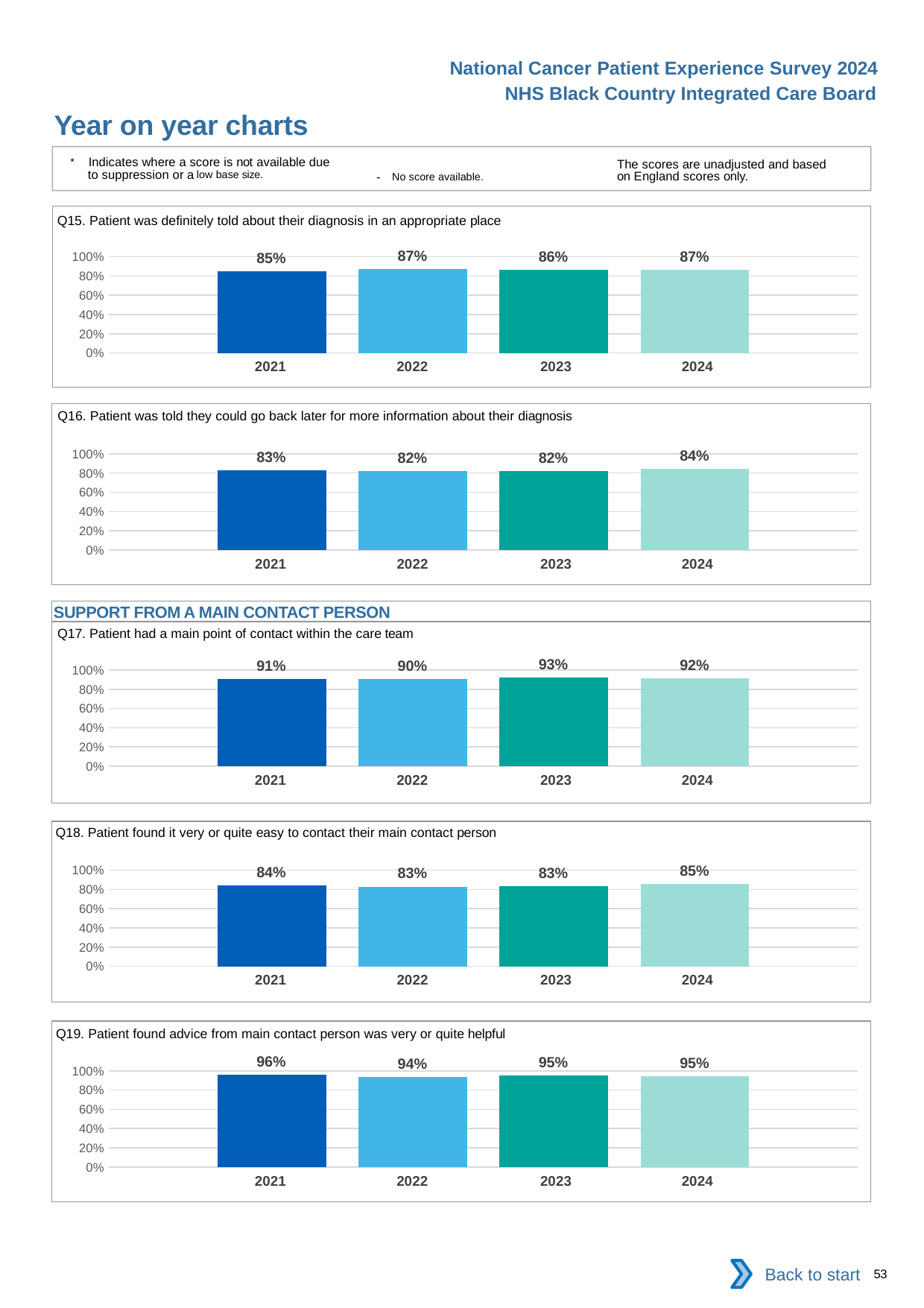
How many years are shown in the Q15 chart? 4 In the Q15 chart, what is the value for 2021? 85% What kind of chart is the Q17 chart? bar chart In the Q18 chart, what is the difference between the 2024 and 2021 values? 1% In the Q17 chart, what is the difference between the 2023 and 2022 values? 3% In the Q16 chart, what is the value for 2022? 82% In the Q16 chart, which year has the highest value? 2024 In the Q19 chart, which is larger, the value for 2021 or the value for 2023? 2021 In the Q19 chart, which year has the lowest value? 2022 In the Q18 chart, what is the value for 2024? 85% What is the title of the section heading above the Q17 chart? SUPPORT FROM A MAIN CONTACT PERSON In the Q17 chart, which year has the highest value? 2023